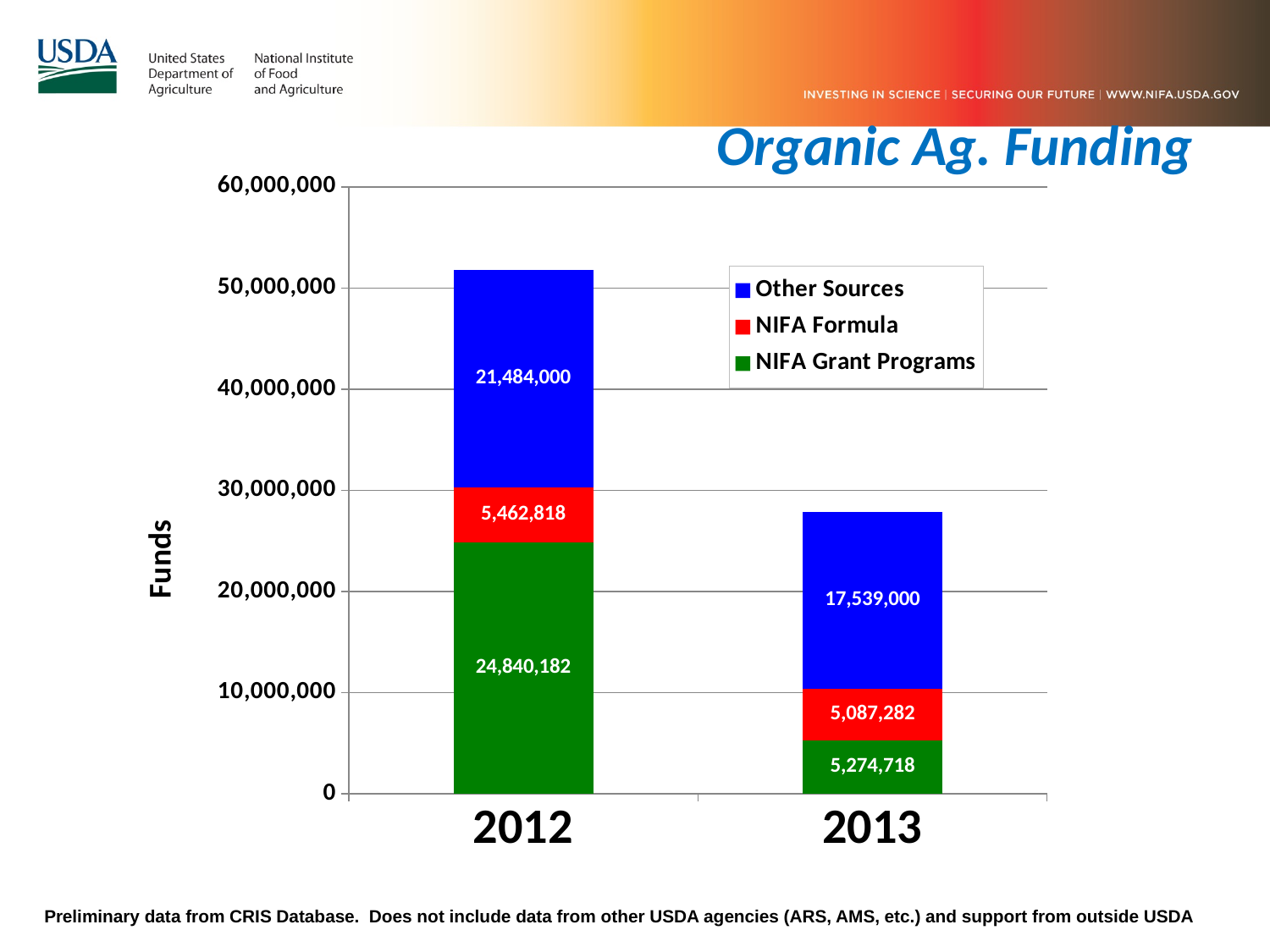
How many series does the legend list? 3 What is the difference between NIFA Grant Programs funding in 2012 and 2013? 19,565,464 What type of chart is shown on the slide? Stacked bar chart Is the total for 2013 greater or less than 30,000,000? less What is the value for NIFA Formula in 2013? 5,087,282 What is the total funding for 2013? 27,901,000 What is the total funding for 2012? 51,787,000 Which series is shown in green? NIFA Grant Programs What is the value for Other Sources in 2013? 17,539,000 Which year has the higher total funding? 2012 How many years are shown on the x axis? 2 What is the value for NIFA Grant Programs in 2012? 24,840,182